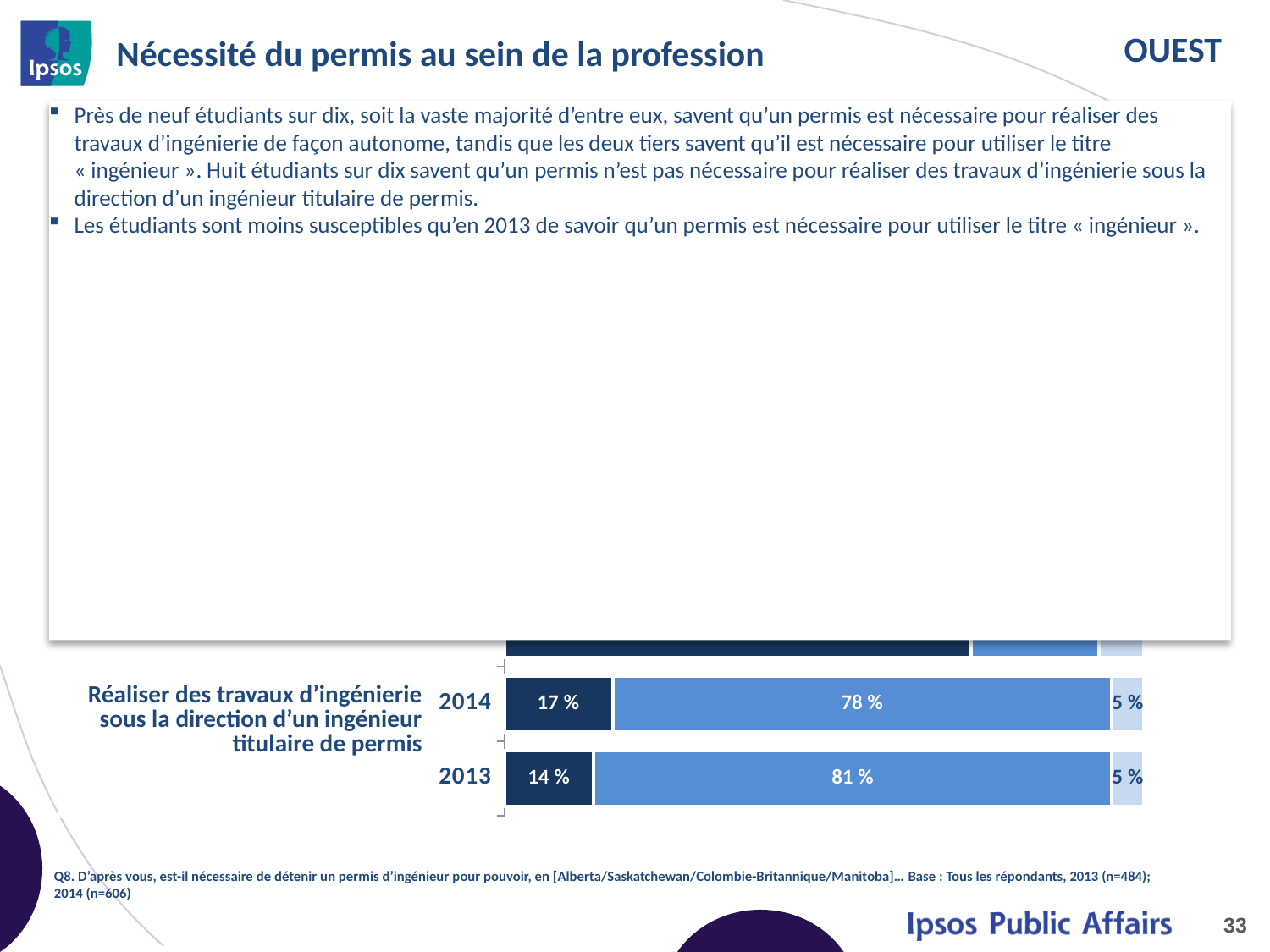
For 'Réaliser des travaux d'ingénierie sous la direction d'un ingénieur titulaire de permis', what is the total of the 2014 bar? 100 % For 'Réaliser des travaux d'ingénierie sous la direction d'un ingénieur titulaire de permis', what is the value of the dark blue segment for 2013? 14 % For 'Réaliser des travaux d'ingénierie sous la direction d'un ingénieur titulaire de permis', which year has the larger dark blue segment, 2013 or 2014? 2014 For 'Réaliser des travaux d'ingénierie sous la direction d'un ingénieur titulaire de permis', what is the value of the light blue segment for 2014? 5 % For 'Réaliser des travaux d'ingénierie sous la direction d'un ingénieur titulaire de permis', what is the difference between the medium blue segments for 2013 and 2014? 3 % For 'Réaliser des travaux d'ingénierie sous la direction d'un ingénieur titulaire de permis', what is the value of the dark blue segment for 2014? 17 % For 'Réaliser des travaux d'ingénierie sous la direction d'un ingénieur titulaire de permis', what is the value of the medium blue segment for 2014? 78 % What kind of chart is shown on the slide? stacked bar chart For 'Réaliser des travaux d'ingénierie sous la direction d'un ingénieur titulaire de permis', which year has the larger medium blue segment, 2013 or 2014? 2013 For 'Réaliser des travaux d'ingénierie sous la direction d'un ingénieur titulaire de permis', what is the difference between the dark blue segments for 2014 and 2013? 3 % Which two years are compared in the bars for 'Réaliser des travaux d'ingénierie sous la direction d'un ingénieur titulaire de permis'? 2014 and 2013 For 'Réaliser des travaux d'ingénierie sous la direction d'un ingénieur titulaire de permis', what is the value of the medium blue segment for 2013? 81 %